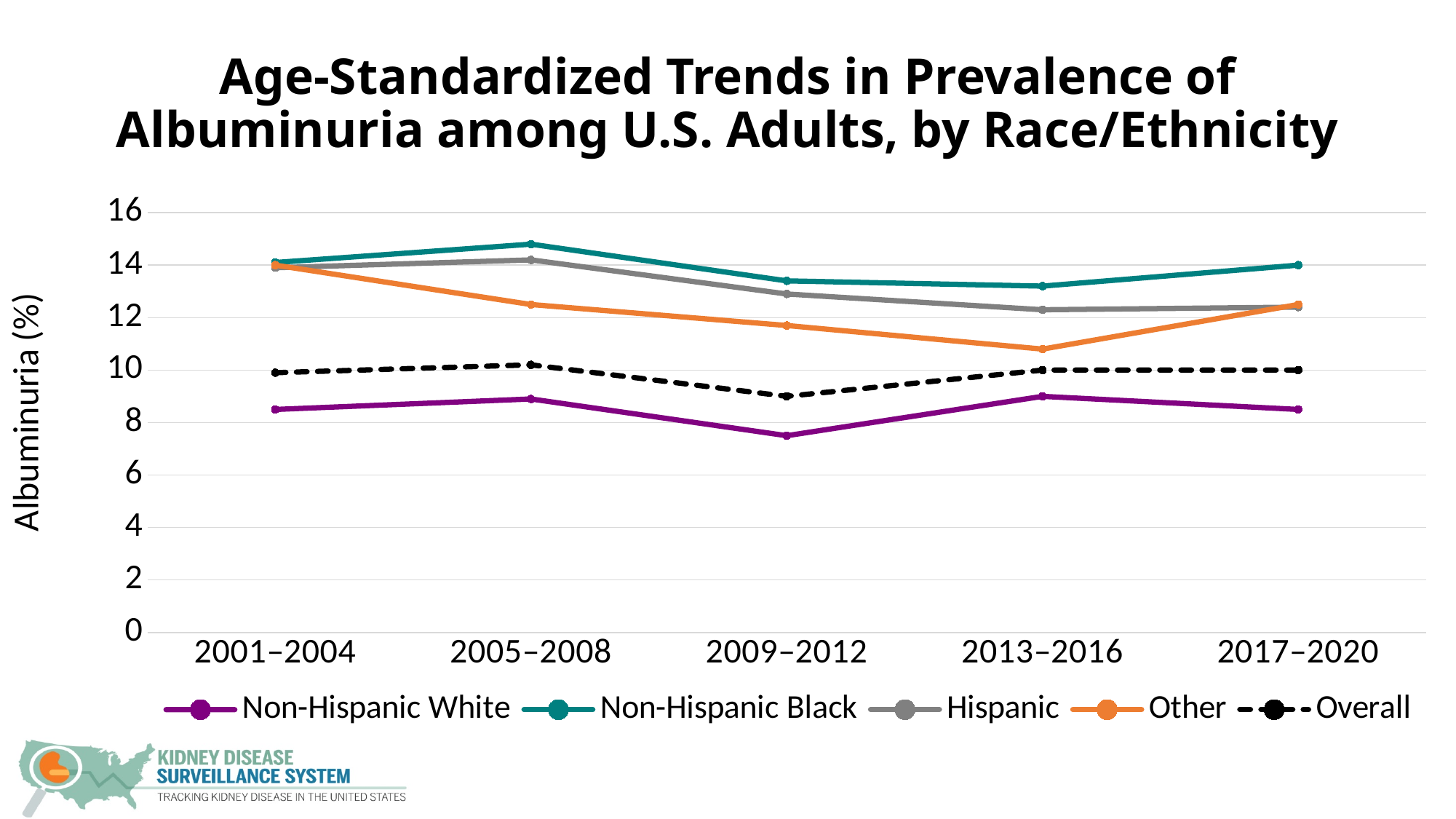
Does the value for Other rise or fall from 2001–2004 to 2013–2016? fall How many series does the legend list? 5 Is the value for Other in 2013–2016 greater or less than 12? less In which period is the Non-Hispanic White value lowest? 2009–2012 How many time periods are shown on the x axis? 5 In 2013–2016, which is larger: the value for Hispanic or the value for Other? Hispanic Is the value for Non-Hispanic Black in 2005–2008 greater or less than 14? greater Is the value for Non-Hispanic White in 2009–2012 greater or less than 8? less What kind of chart is shown on the slide? line chart Which race/ethnicity group has the lowest albuminuria prevalence in 2009–2012? Non-Hispanic White Which race/ethnicity group has the highest albuminuria prevalence in 2005–2008? Non-Hispanic Black Which series is drawn with a dashed line? Overall